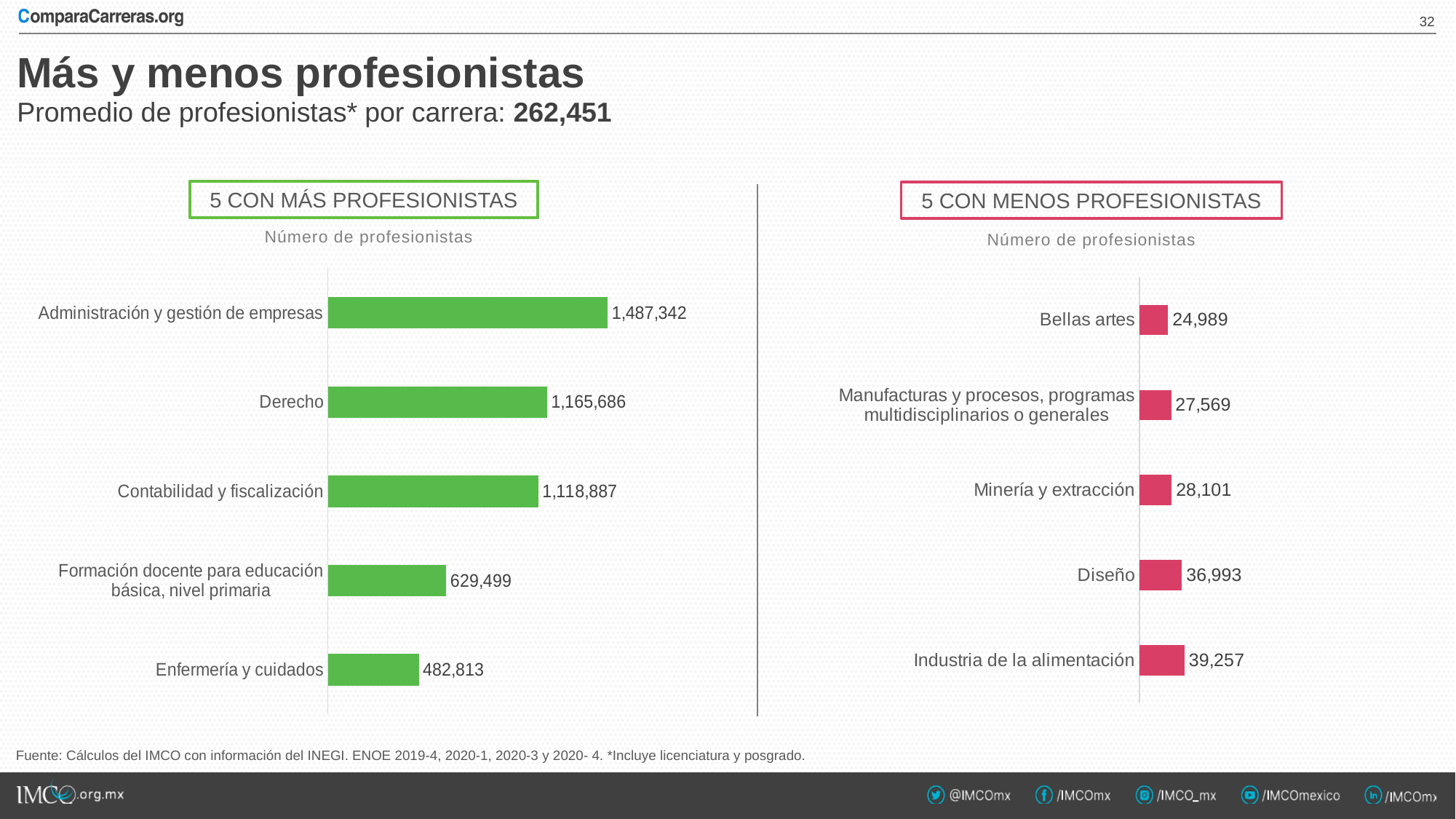
In the '5 CON MENOS PROFESIONISTAS' chart, which category has the highest value? Industria de la alimentación In the '5 CON MÁS PROFESIONISTAS' chart, what is the difference between Administración y gestión de empresas and Derecho? 321,656 In the '5 CON MÁS PROFESIONISTAS' chart, what is the value for Enfermería y cuidados? 482,813 In the '5 CON MENOS PROFESIONISTAS' chart, what is the value for Diseño? 36,993 In the '5 CON MENOS PROFESIONISTAS' chart, what is the difference between Industria de la alimentación and Bellas artes? 14,268 What type of chart is the '5 CON MÁS PROFESIONISTAS' chart? Bar chart In the '5 CON MÁS PROFESIONISTAS' chart, which is larger: Contabilidad y fiscalización or Formación docente para educación básica, nivel primaria? Contabilidad y fiscalización How many categories are shown in the '5 CON MENOS PROFESIONISTAS' chart? 5 In the '5 CON MENOS PROFESIONISTAS' chart, which category has the lowest value? Bellas artes In the '5 CON MENOS PROFESIONISTAS' chart, what is the value for Minería y extracción? 28,101 In the '5 CON MÁS PROFESIONISTAS' chart, which category has the highest value? Administración y gestión de empresas In the '5 CON MÁS PROFESIONISTAS' chart, what is the value for Derecho? 1,165,686